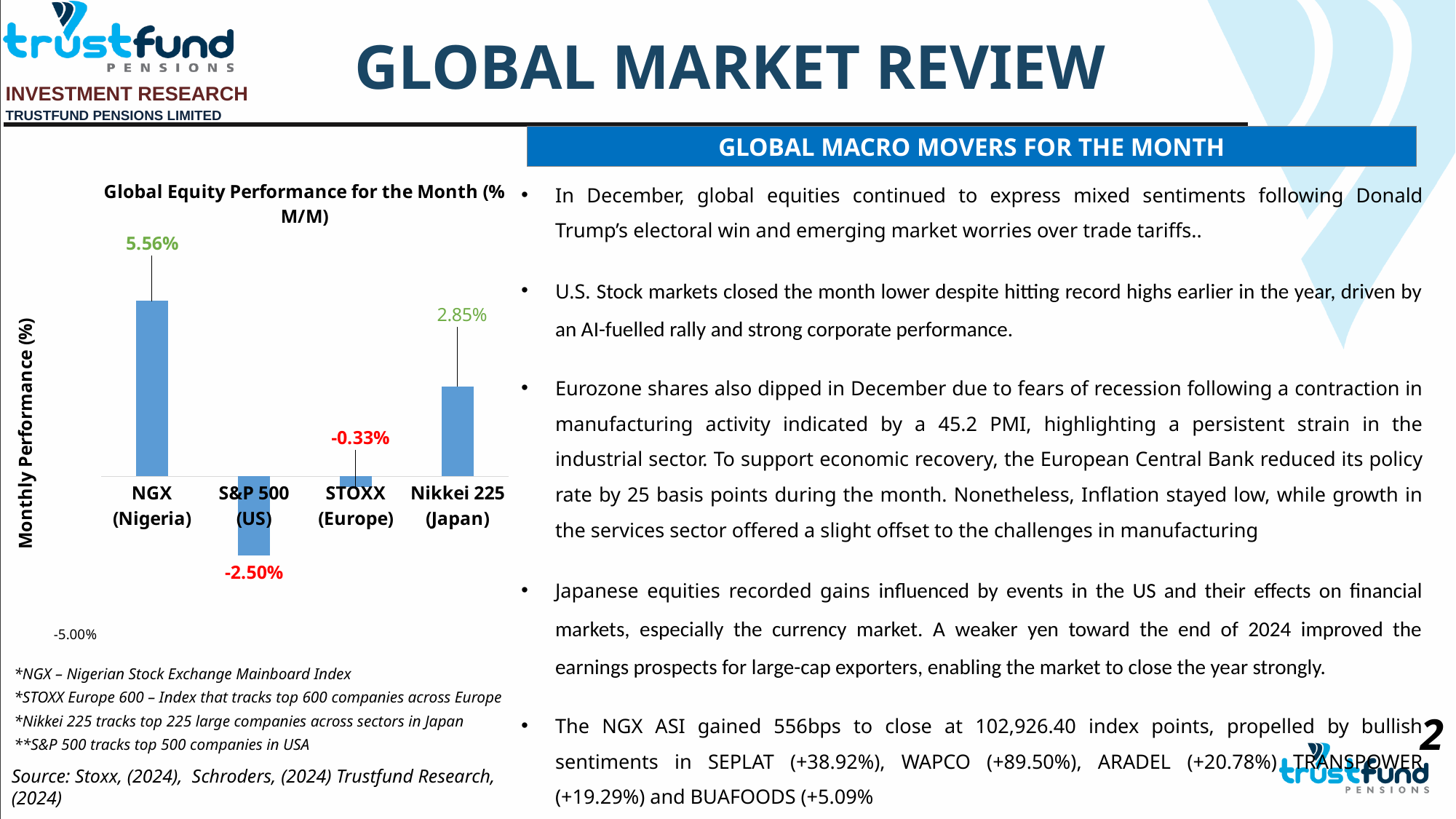
What is the label of the vertical axis of the chart? Monthly Performance (%) What is the monthly performance value for NGX (Nigeria)? 5.56% What is the monthly performance value for STOXX (Europe)? -0.33% What type of chart is used to show Global Equity Performance for the Month? Bar chart Which index has the highest monthly performance? NGX (Nigeria) What is the difference between the monthly performance of NGX (Nigeria) and Nikkei 225 (Japan)? 2.71% Which has the larger monthly performance, STOXX (Europe) or Nikkei 225 (Japan)? Nikkei 225 (Japan) What is the title of the chart? Global Equity Performance for the Month (% M/M) What is the monthly performance value for Nikkei 225 (Japan)? 2.85% What is the monthly performance value for S&P 500 (US)? -2.50% How many indices are shown in the chart? 4 Which index has the lowest monthly performance? S&P 500 (US)